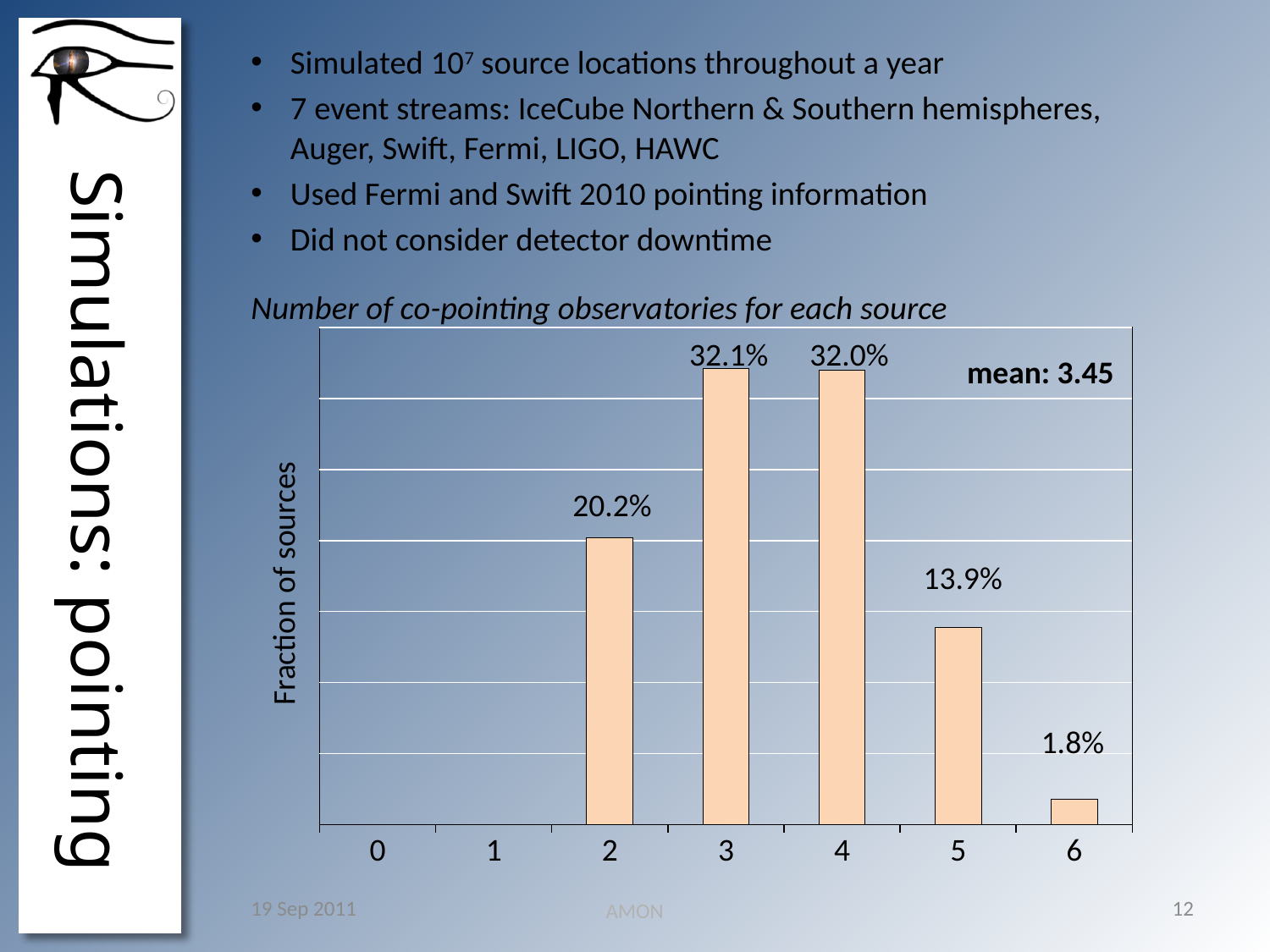
Which number of co-pointing observatories has the highest fraction of sources? 3 What is the value shown for category 2 on the x axis? 20.2% What mean value is annotated on the chart? 3.45 What fraction of sources have 5 co-pointing observatories? 13.9% What is the difference in percentage points between the values for categories 3 and 5? 18.2 How many categories are shown on the x axis? 7 What kind of chart is shown on the slide? bar chart What is the label of the y axis? Fraction of sources Among the bars with data labels, which category has the lowest fraction of sources? 6 Which is larger, the fraction of sources for category 2 or for category 5? category 2 What fraction of sources have 3 co-pointing observatories? 32.1% What is the value shown for category 6 on the x axis? 1.8%